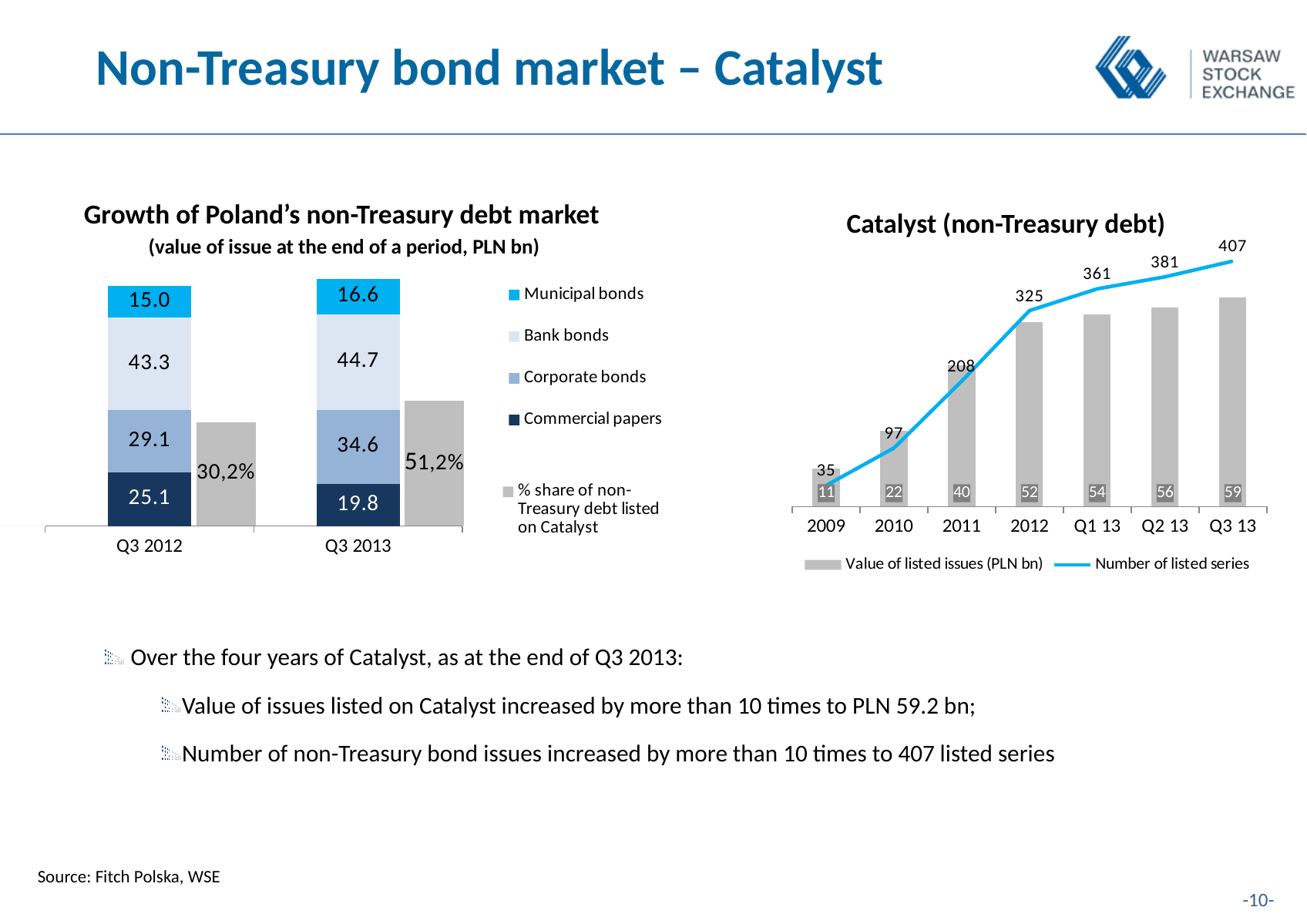
In the 'Catalyst (non-Treasury debt)' chart, what is the value of listed issues (PLN bn) in Q2 13? 56 In the 'Growth of Poland's non-Treasury debt market' chart, what is the value of Bank bonds in Q3 2013? 44.7 In the 'Catalyst (non-Treasury debt)' chart, what is the number of listed series in 2011? 208 In the 'Growth of Poland's non-Treasury debt market' chart, what is the total of the stacked bar for Q3 2012? 112.5 In the 'Catalyst (non-Treasury debt)' chart, how many periods are shown on the x axis? 7 In the 'Growth of Poland's non-Treasury debt market' chart, what is the value of Commercial papers in Q3 2012? 25.1 In the 'Growth of Poland's non-Treasury debt market' chart, by how much did Corporate bonds change from Q3 2012 to Q3 2013? 5.5 In the 'Growth of Poland's non-Treasury debt market' chart, how many bond types does the legend list (excluding the % share series)? 4 In the 'Growth of Poland's non-Treasury debt market' chart, which is larger: Commercial papers in Q3 2012 or in Q3 2013? Q3 2012 In the 'Growth of Poland's non-Treasury debt market' chart, what is the % share of non-Treasury debt listed on Catalyst in Q3 2013? 51,2% In the 'Catalyst (non-Treasury debt)' chart, what is the difference in the number of listed series between 2012 and 2011? 117 In the 'Catalyst (non-Treasury debt)' chart, which period has the highest number of listed series? Q3 13